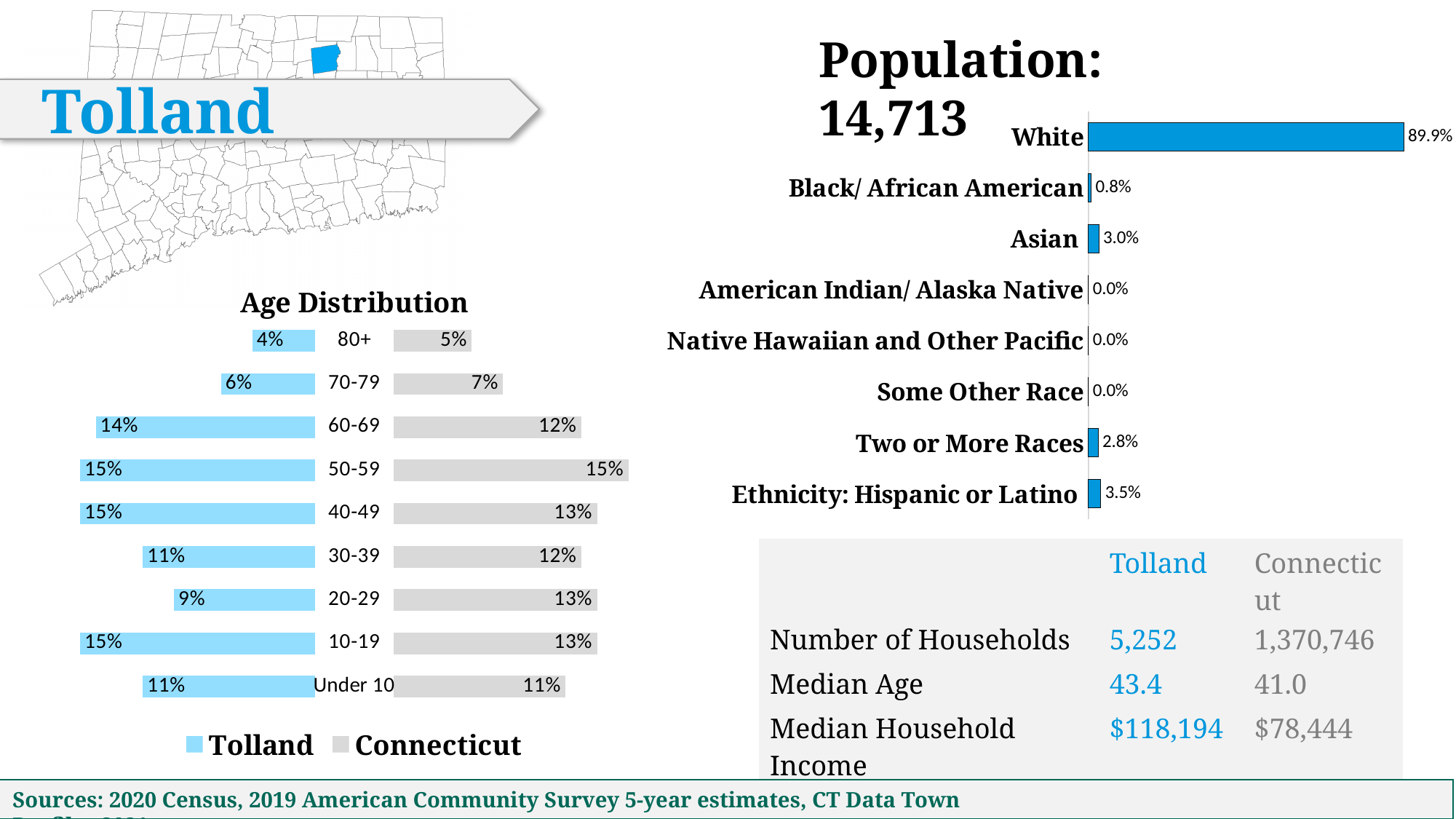
In the Age Distribution chart, which is larger for the 60-69 age group, the Tolland value or the Connecticut value? Tolland In the Age Distribution chart, what is the Tolland value for the 60-69 age group? 14% How many categories are shown in the race and ethnicity bar chart on the right? 8 In the Age Distribution chart, which age group has the lowest Tolland value? 80+ How many age groups are shown in the Age Distribution chart? 9 How many series does the legend of the Age Distribution chart list? 2 In the Age Distribution chart, what is the Connecticut value for the 20-29 age group? 13% In the race and ethnicity bar chart on the right, what is the difference between the values for Ethnicity: Hispanic or Latino and Two or More Races? 0.7% In the race and ethnicity bar chart on the right, which category has the highest value? White What kind of chart is the Age Distribution chart? bar chart In the race and ethnicity bar chart on the right, what is the value for Asian? 3.0% In the Age Distribution chart, what is the difference between the Tolland and Connecticut values for the 20-29 age group? 4%